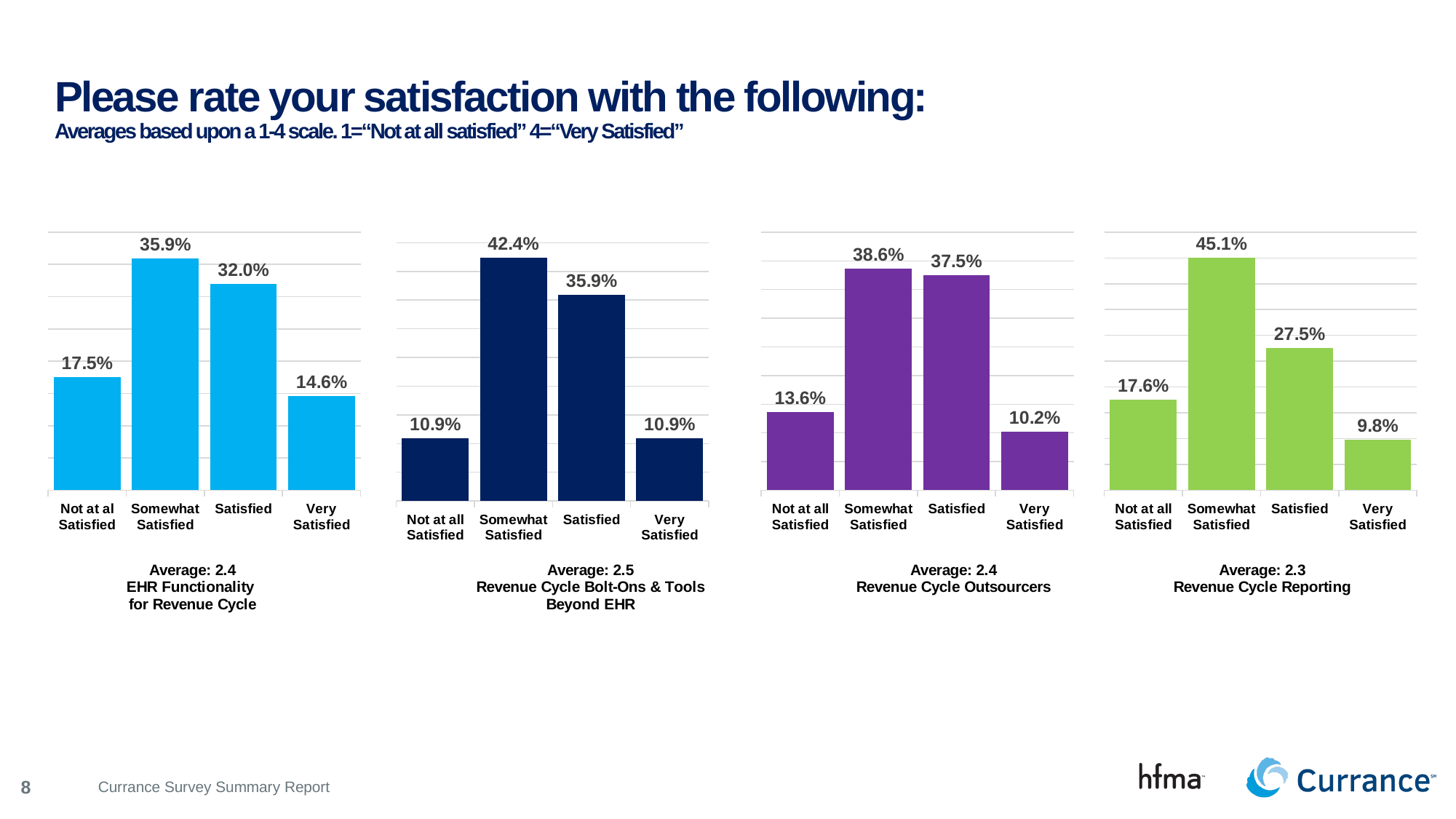
What is the average satisfaction score shown for Revenue Cycle Bolt-Ons & Tools Beyond EHR? 2.5 In the Revenue Cycle Reporting chart, which category has the highest value? Somewhat Satisfied In the Revenue Cycle Outsourcers chart, which is larger: Not at all Satisfied or Very Satisfied? Not at all Satisfied How many charts are shown on the slide? 4 In the Revenue Cycle Outsourcers chart, what percentage of respondents were Satisfied? 37.5% How many categories are shown in the Revenue Cycle Bolt-Ons & Tools Beyond EHR chart? 4 What kind of chart is the Revenue Cycle Reporting chart? Bar chart In the Revenue Cycle Reporting chart, what is the difference between the Satisfied and Very Satisfied values? 17.7% In the Revenue Cycle Bolt-Ons & Tools Beyond EHR chart, what percentage of respondents were Not at all Satisfied? 10.9% In the EHR Functionality for Revenue Cycle chart, what percentage of respondents were Somewhat Satisfied? 35.9% In the Revenue Cycle Reporting chart, which category has the lowest value? Very Satisfied In the EHR Functionality for Revenue Cycle chart, what is the difference between the Somewhat Satisfied and Very Satisfied values? 21.3%